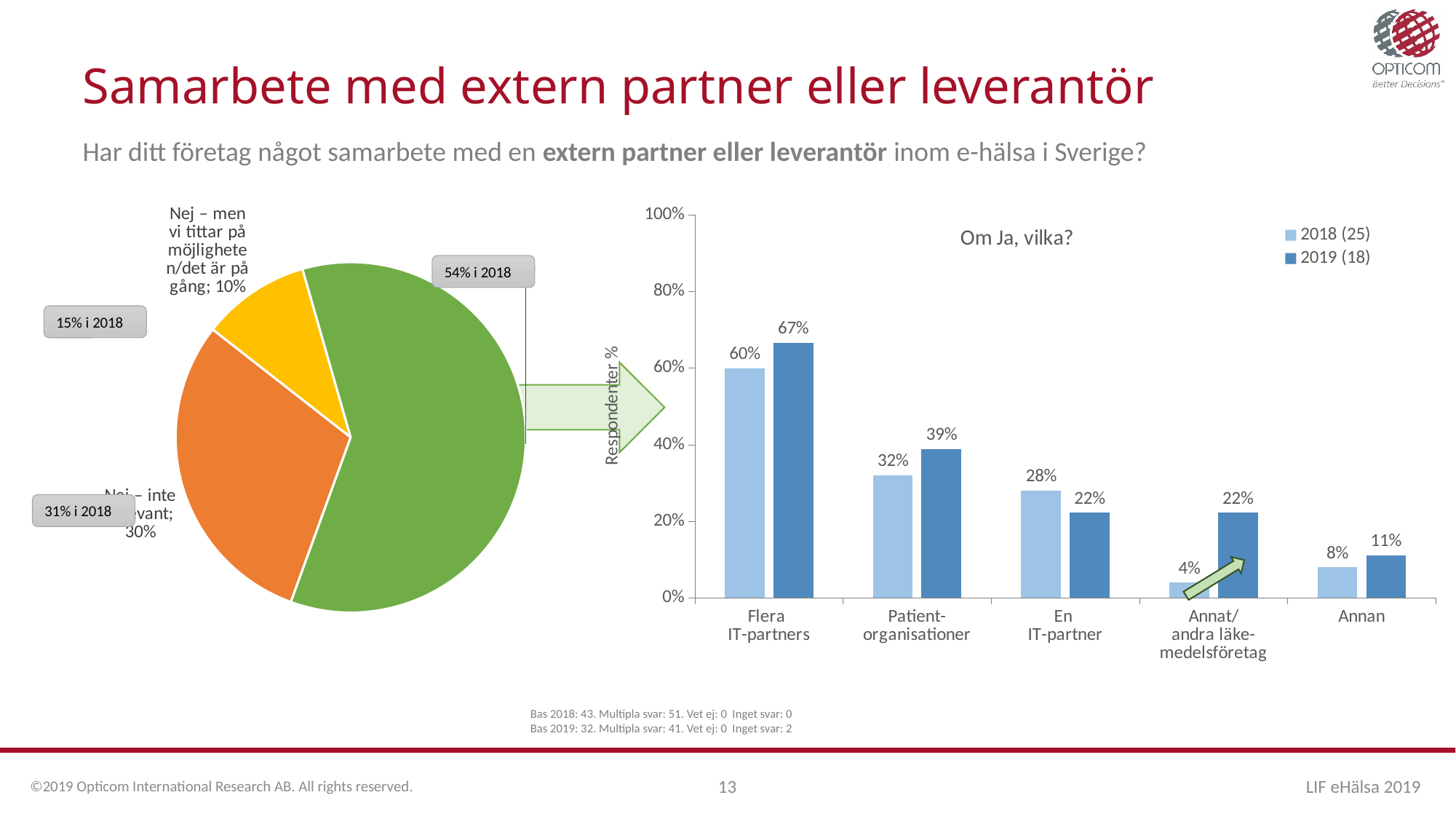
In the bar chart 'Om Ja, vilka?', what is the 2019 value for Flera IT-partners? 67% What kind of chart is the chart on the left of the slide? pie chart In the bar chart 'Om Ja, vilka?', which category has the lowest 2018 value? Annat/andra läkemedelsföretag In the bar chart 'Om Ja, vilka?', what are the two legend entries? 2018 (25) and 2019 (18) How many categories are shown on the x axis of the bar chart 'Om Ja, vilka?'? 5 In the bar chart 'Om Ja, vilka?', what is the 2018 value for Patientorganisationer? 32% In the bar chart 'Om Ja, vilka?', what is the 2019 value for Annat/andra läkemedelsföretag? 22% In the bar chart 'Om Ja, vilka?', what is the difference between the 2019 and 2018 values for Annat/andra läkemedelsföretag? 18 percentage points How many series does the legend of the bar chart 'Om Ja, vilka?' list? 2 In the bar chart 'Om Ja, vilka?', is the 2018 value for En IT-partner larger or smaller than the 2019 value? larger In the bar chart 'Om Ja, vilka?', which category has the highest 2019 value? Flera IT-partners In the pie chart on the left, what share is shown for the slice 'Nej – men vi tittar på möjligheten/det är på gång'? 10%